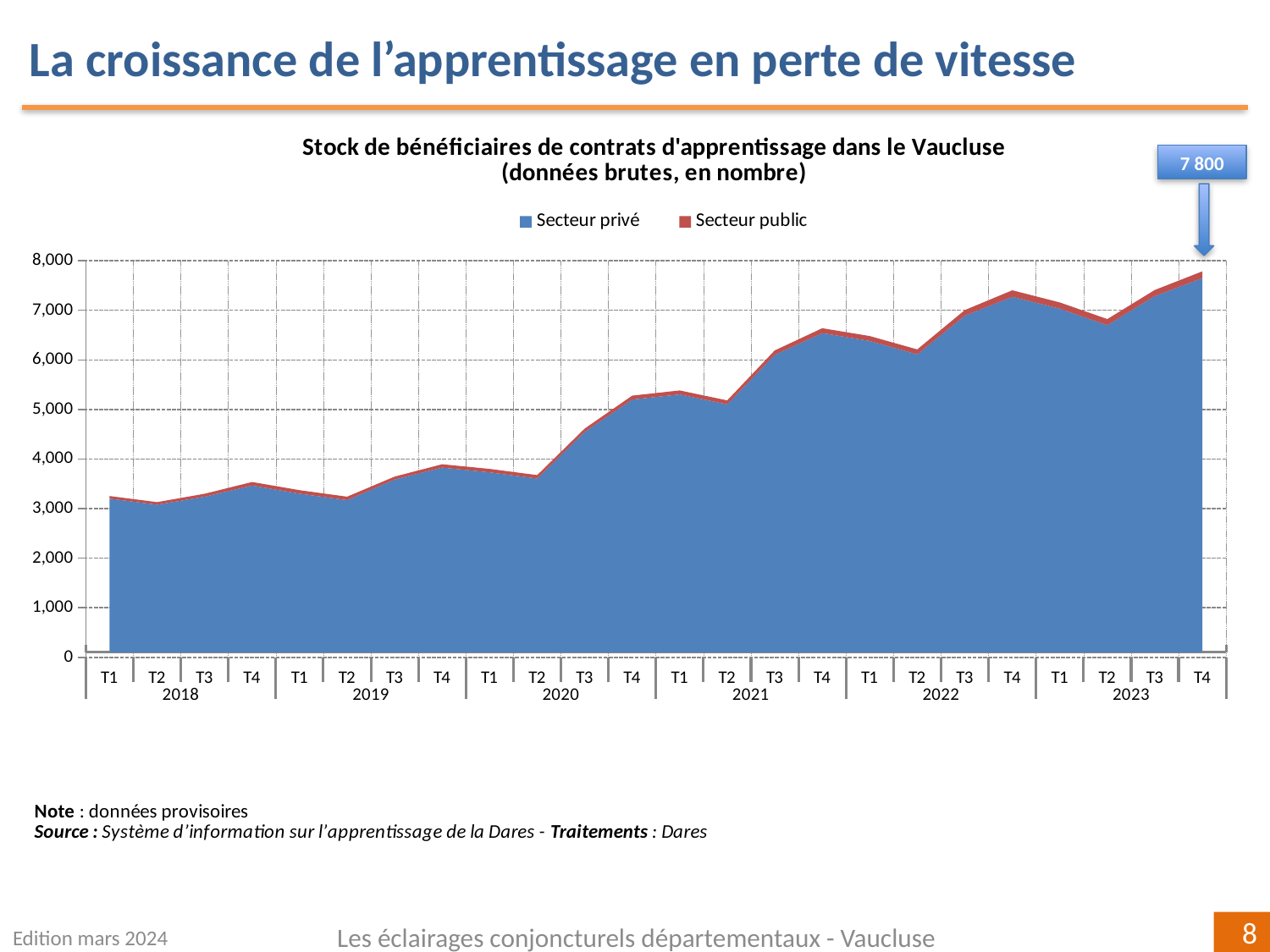
What is the total stock of apprenticeship beneficiaries indicated for T4 2023? 7 800 Overall, do the values rise or fall from T1 2018 to T4 2023? rise Is the total value for T2 2020 greater or less than 4,000? less What kind of chart is shown on the slide? area chart How many quarters are plotted on the x axis? 24 Which series accounts for the larger share of the stock, Secteur privé or Secteur public? Secteur privé Which quarter has the highest total stock of apprenticeship beneficiaries? T4 2023 How many series does the legend list? 2 Is the total value for T2 2023 greater or less than 7,000? less Is the total value for T1 2018 greater or less than 3,000? greater Which is larger, the total for T4 2020 or the total for T4 2021? T4 2021